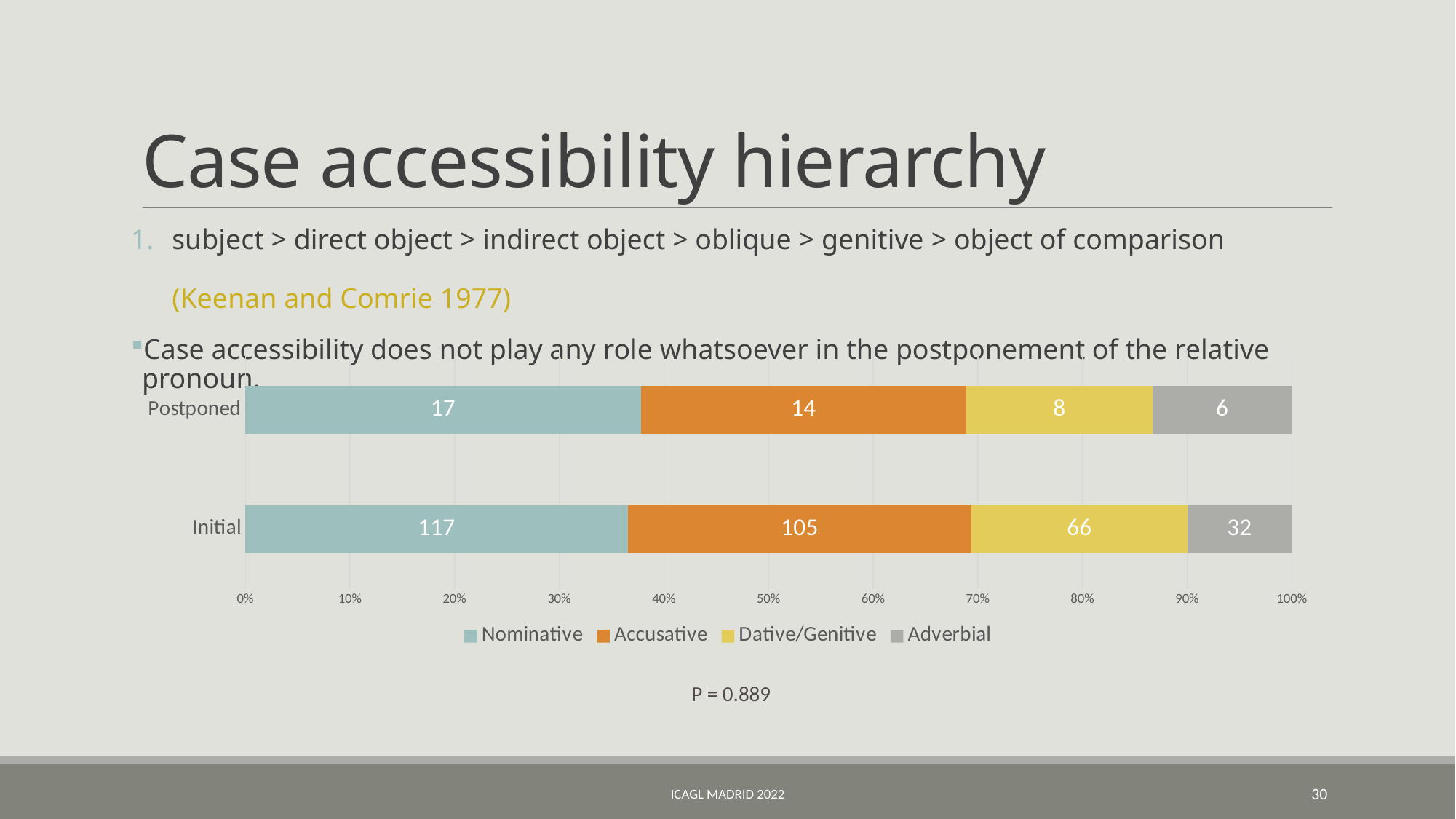
What kind of chart is shown on the slide? Stacked bar chart What is the difference between the Nominative values for Initial and Postponed? 100 What is the total of the Initial bar? 320 Which series has the smallest value in the Postponed bar? Adverbial What is the Accusative value for the Initial bar? 105 Which series has the largest value in the Initial bar? Nominative How many series does the legend list? 4 What is the total of the Postponed bar? 45 What is the Nominative value for the Postponed bar? 17 Which is larger: the Accusative value for Postponed or the Dative/Genitive value for Postponed? Accusative What is the Adverbial value for the Postponed bar? 6 What is the Dative/Genitive value for the Initial bar? 66